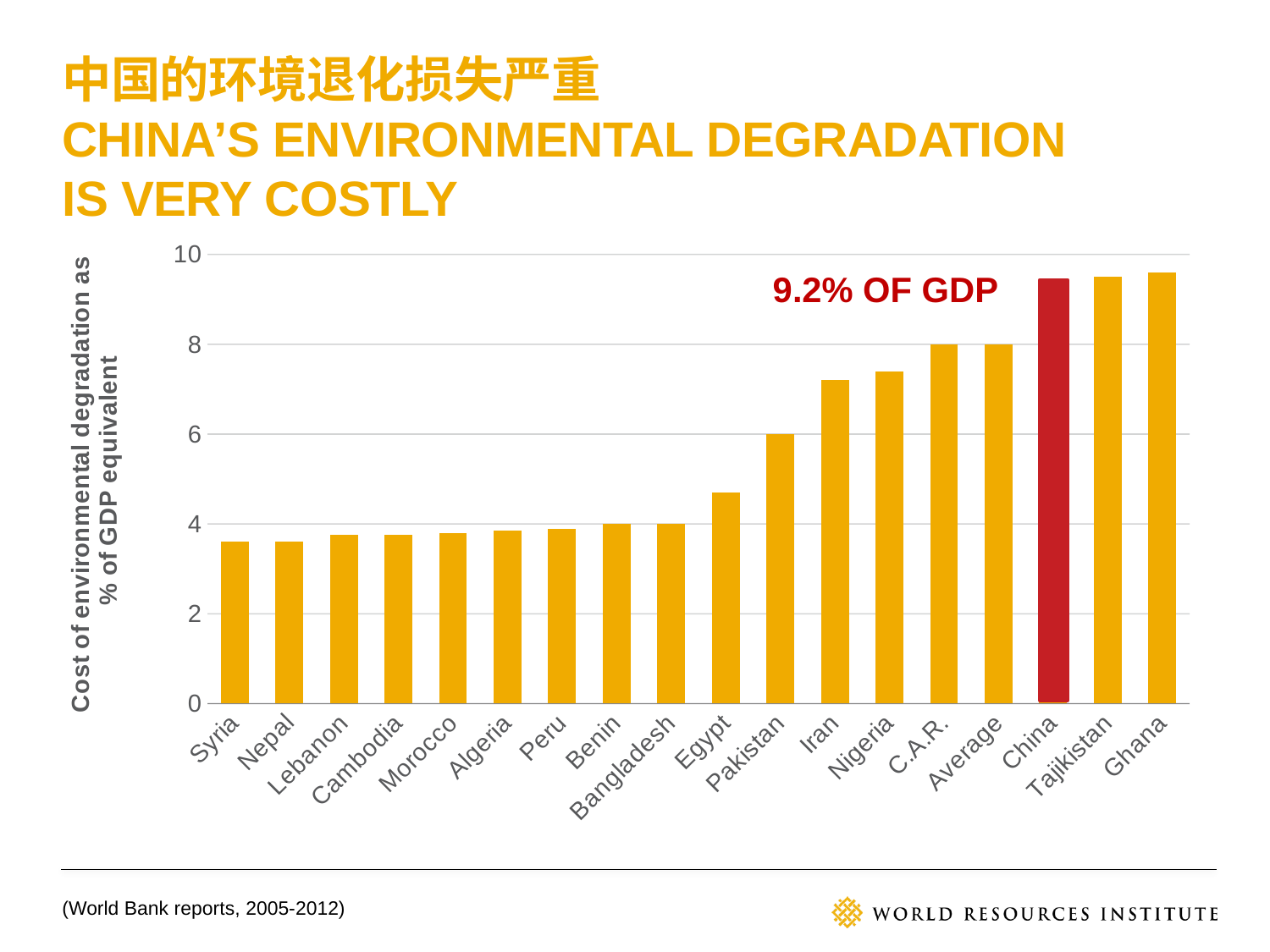
What kind of chart is shown on the slide? bar chart Do the bar values generally rise or fall from left to right along the x axis? rise Which has a larger value, Egypt or Pakistan? Pakistan Is the value for Egypt greater or less than 4? greater Which country's bar is coloured red instead of yellow? China Is the value for Nigeria greater or less than 8? less Which has a larger value, Iran or Egypt? Iran What value is annotated for China in the chart? 9.2% OF GDP Is the value for China greater or less than 8? greater How many countries/categories are shown along the x axis of the chart? 18